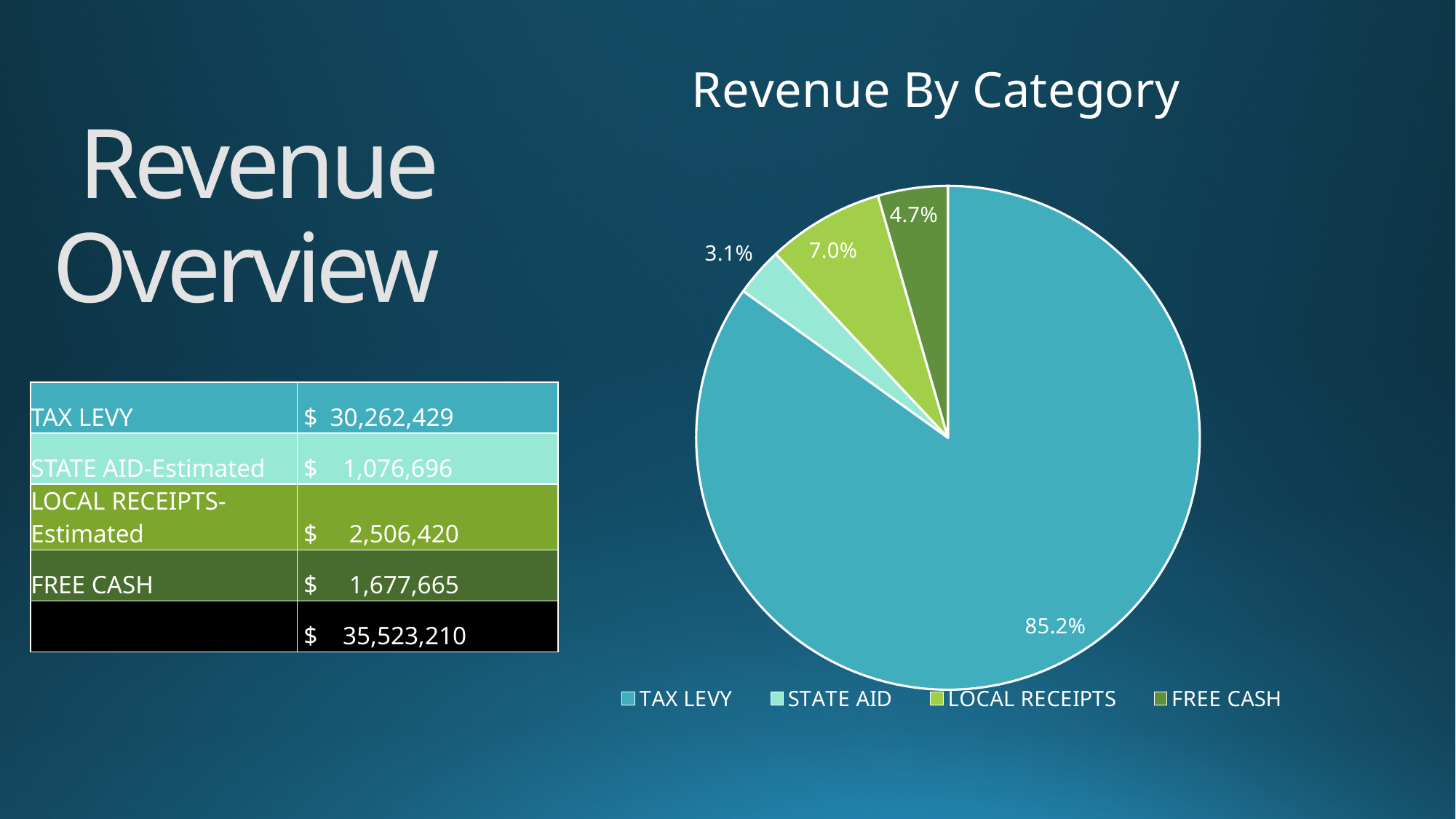
Which category has the largest slice in the "Revenue By Category" pie chart? TAX LEVY In the "Revenue By Category" pie chart, what share does FREE CASH have? 4.7% In the "Revenue By Category" pie chart, what share does LOCAL RECEIPTS have? 7.0% How many entries does the legend of the "Revenue By Category" pie chart list? 4 In the "Revenue By Category" pie chart, what is the difference in percentage points between the LOCAL RECEIPTS and FREE CASH slices? 2.3 In the "Revenue By Category" pie chart, what share does STATE AID have? 3.1% Which category has the smallest slice in the "Revenue By Category" pie chart? STATE AID What is the title of the pie chart on the slide? Revenue By Category How many slices does the "Revenue By Category" pie chart have? 4 In the "Revenue By Category" pie chart, which slice is larger: LOCAL RECEIPTS or FREE CASH? LOCAL RECEIPTS What kind of chart is shown under the title "Revenue By Category"? pie chart